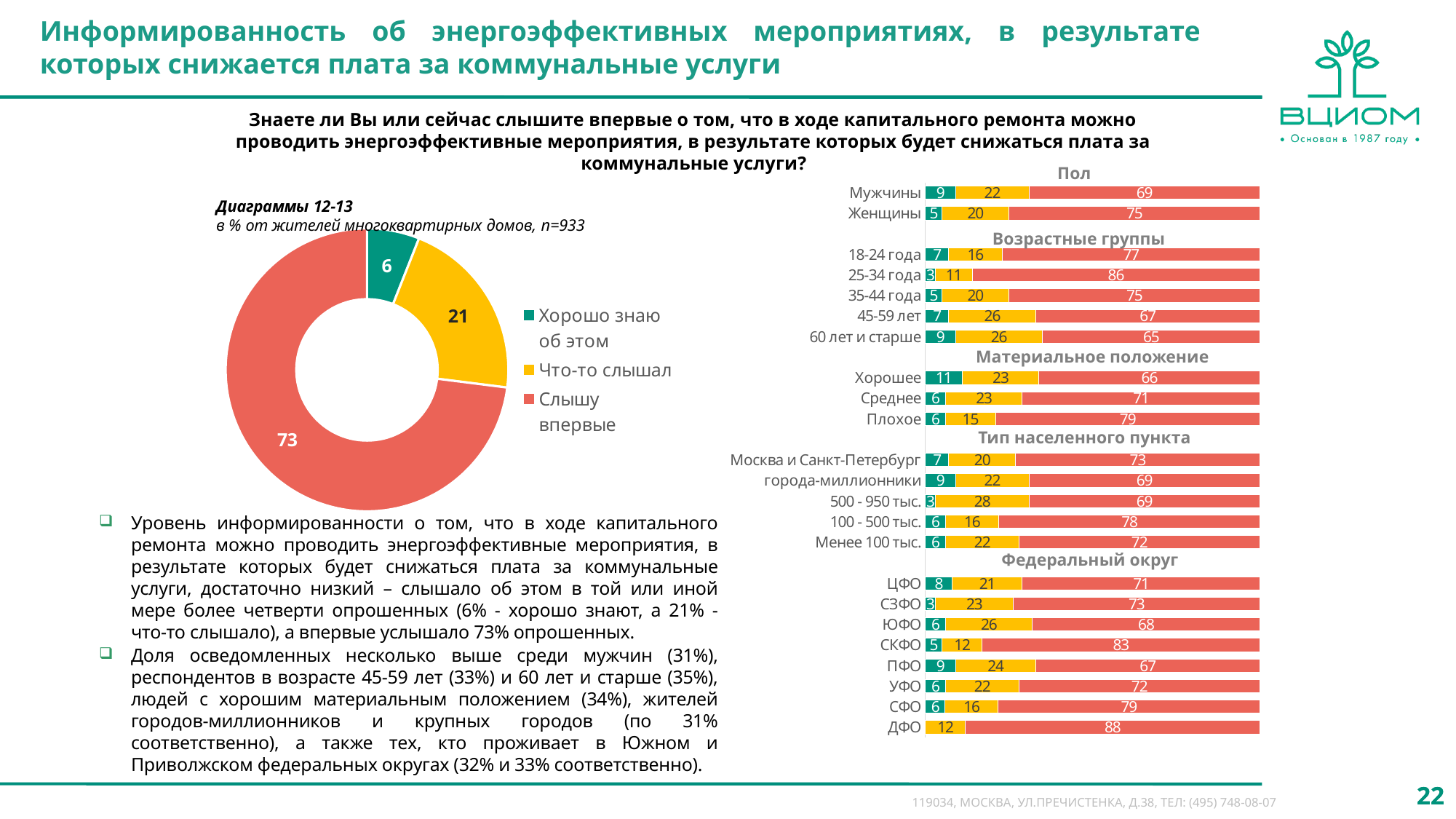
In the donut chart on the left, how many categories does the legend list? 3 In the donut chart on the left, which category has the smallest share? Хорошо знаю об этом In the stacked bar chart on the right, what is the value of the red segment ("Слышу впервые") for "25-34 года"? 86 What kind of chart is shown on the left side of the slide? Donut (pie) chart In the stacked bar chart on the right, which has a larger green value ("Хорошо знаю об этом"): "Хорошее" or "Плохое" материальное положение? Хорошее In the stacked bar chart on the right, which federal district (Федеральный округ) has the highest red value ("Слышу впервые")? ДФО What kind of chart is shown on the right side of the slide? Stacked bar chart In the donut chart on the left, what is the value for "Хорошо знаю об этом"? 6 In the donut chart on the left, what is the value for "Слышу впервые"? 73 In the stacked bar chart on the right, what is the difference between the red values for "Мужчины" and "Женщины"? 6 In the stacked bar chart on the right, what is the value of the yellow segment ("Что-то слышал") for "500 - 950 тыс."? 28 In the donut chart on the left, which category has the largest share? Слышу впервые